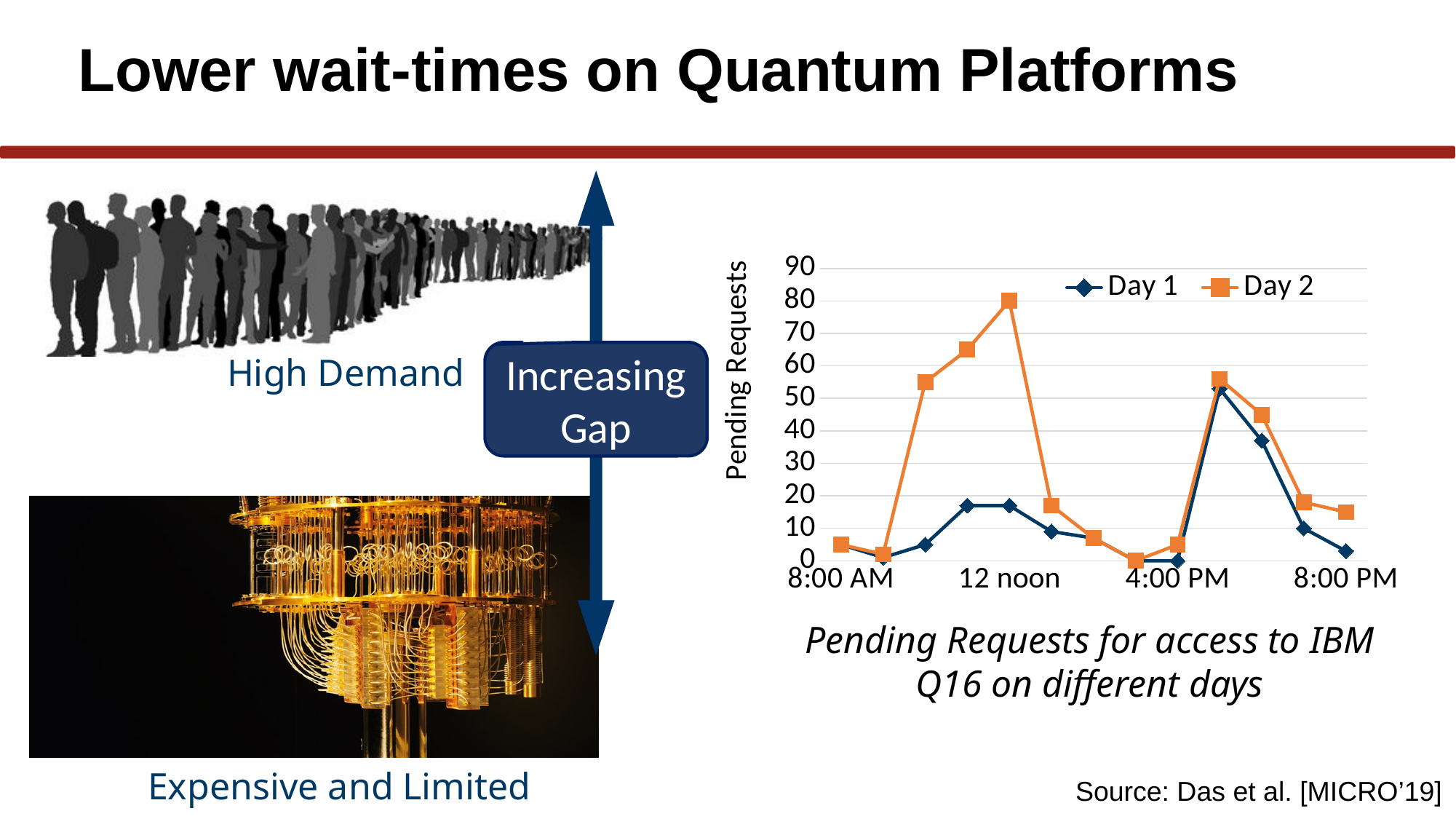
At 8:00 PM, which series has the larger value, Day 1 or Day 2? Day 2 What is the value of Day 2 at 12 noon? 80 What is the label of the chart's vertical axis? Pending Requests Is the value for Day 1 at 12 noon greater or less than 20? less What is the value of Day 1 at 4:00 PM? 0 Does the Day 2 series rise or fall between 8:00 AM and 12 noon? Rise What are the two series named in the chart's legend? Day 1 and Day 2 How many series does the chart's legend list? 2 Is the value for Day 2 at 8:00 PM greater or less than 10? greater What kind of chart is shown on the slide? Line chart At which labelled time does Day 2 reach its highest value? 12 noon At 12 noon, which series has the larger value, Day 1 or Day 2? Day 2